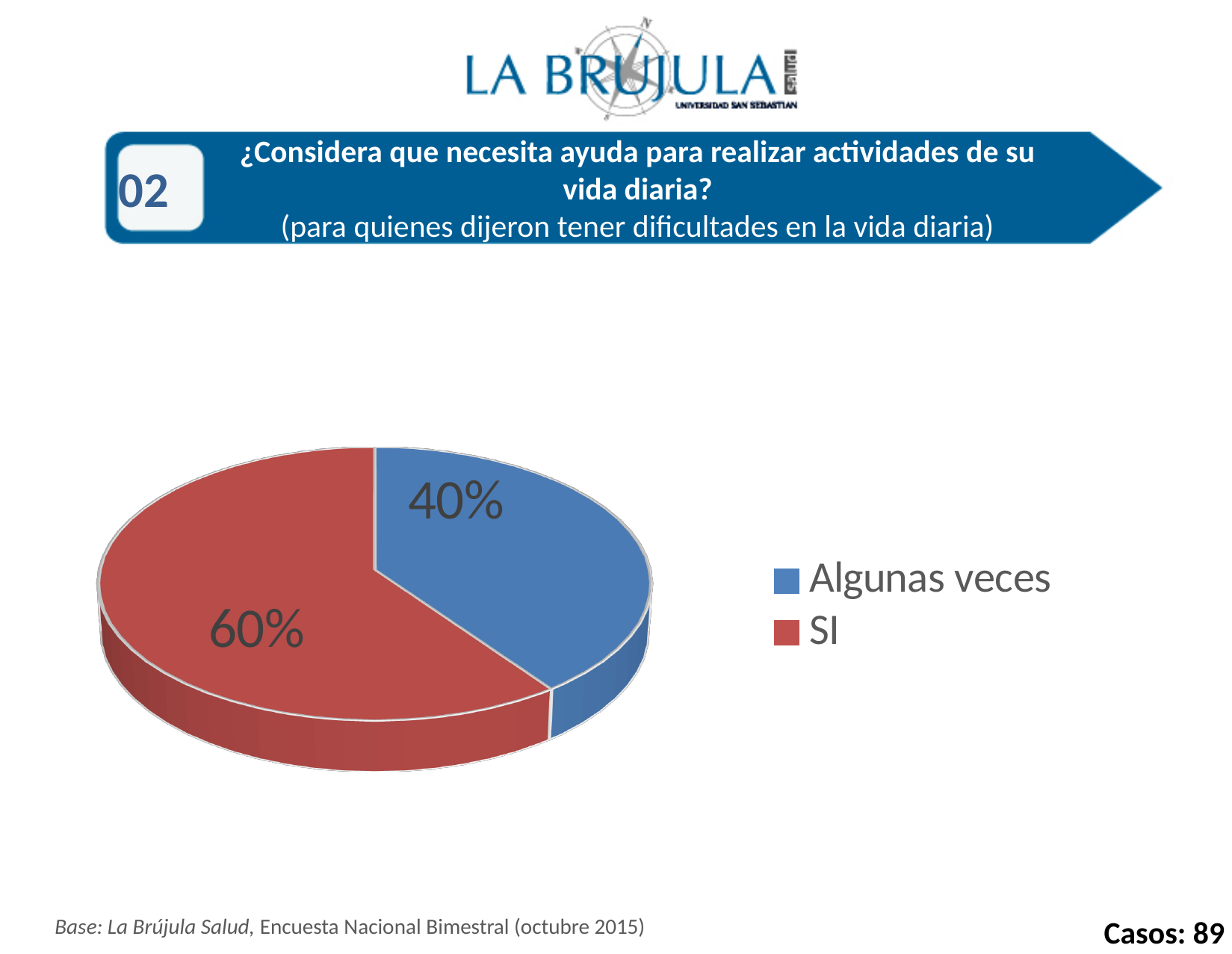
Which category has the largest share of the pie? SI Which category has the smallest share of the pie? Algunas veces What percentage of the pie does the "Algunas veces" slice represent? 40% What percentage of the pie does the "SI" slice represent? 60% How many slices does the pie chart have? 2 What colour is the "Algunas veces" slice? Blue How many entries does the legend list? 2 What colour is the "SI" slice? Red What is the difference in percentage points between the "SI" and "Algunas veces" slices? 20 Is the share for "Algunas veces" greater or less than 50%? less Which is larger, the "SI" slice or the "Algunas veces" slice? SI What kind of chart is shown on the slide? Pie chart